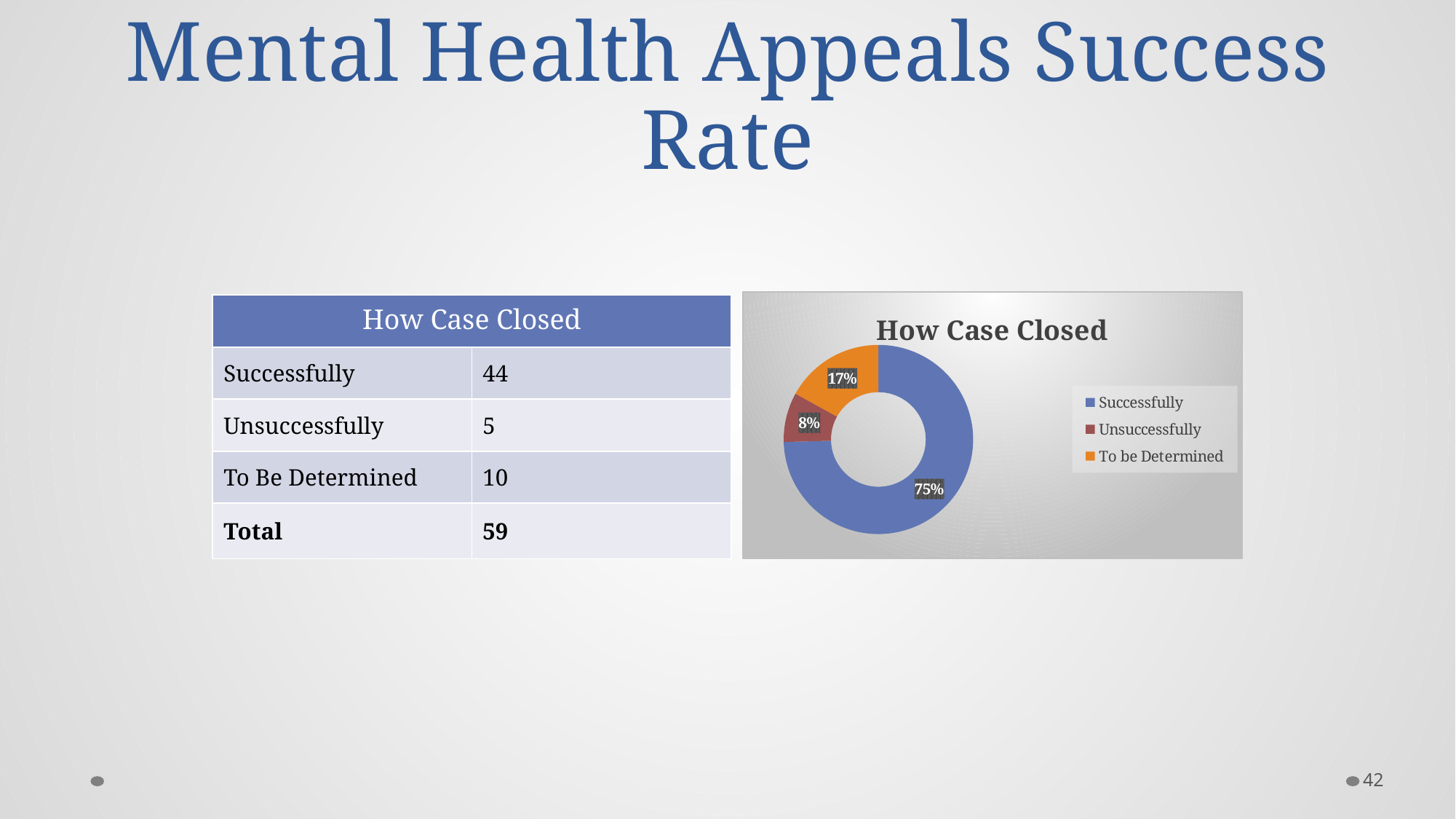
What colour represents the Successfully category in the chart? Blue Which category has the smallest share of the chart? Unsuccessfully How many categories does the chart legend list? 3 What is the difference in percentage points between the Successfully and To be Determined shares? 58 What type of chart is shown on the slide? Doughnut chart What percentage of the chart is labelled for Unsuccessfully? 8% What is the title of the chart? How Case Closed Which category has the largest share of the chart? Successfully Which has a larger share of the chart, To be Determined or Unsuccessfully? To be Determined What percentage of the chart is labelled for To be Determined? 17% What percentage of the chart is labelled for Successfully? 75%